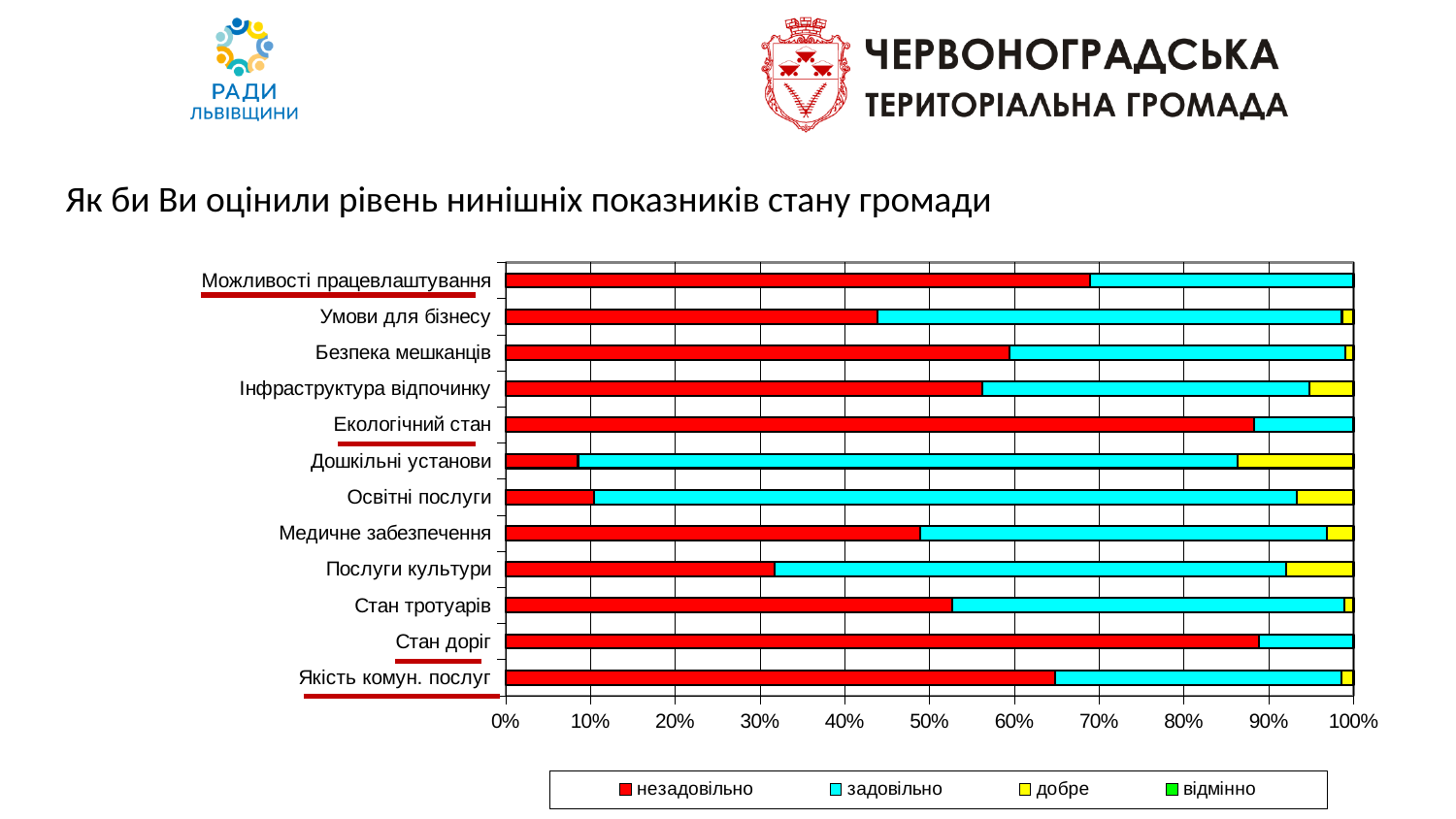
Is the 'незадовільно' value for 'Дошкільні установи' greater or less than 20%? less Is the 'незадовільно' value for 'Умови для бізнесу' greater or less than 50%? less Which has the larger 'незадовільно' share: 'Умови для бізнесу' or 'Безпека мешканців'? Безпека мешканців What are the four entries in the chart legend? незадовільно, задовільно, добре, відмінно Which has the larger 'незадовільно' share: 'Дошкільні установи' or 'Послуги культури'? Послуги культури Which category has the largest 'добре' segment? Дошкільні установи Is the 'незадовільно' value for 'Послуги культури' greater or less than 40%? less How many series does the chart legend list? 4 What kind of chart is shown on the slide? Stacked bar chart How many categories are listed on the vertical axis of the chart? 12